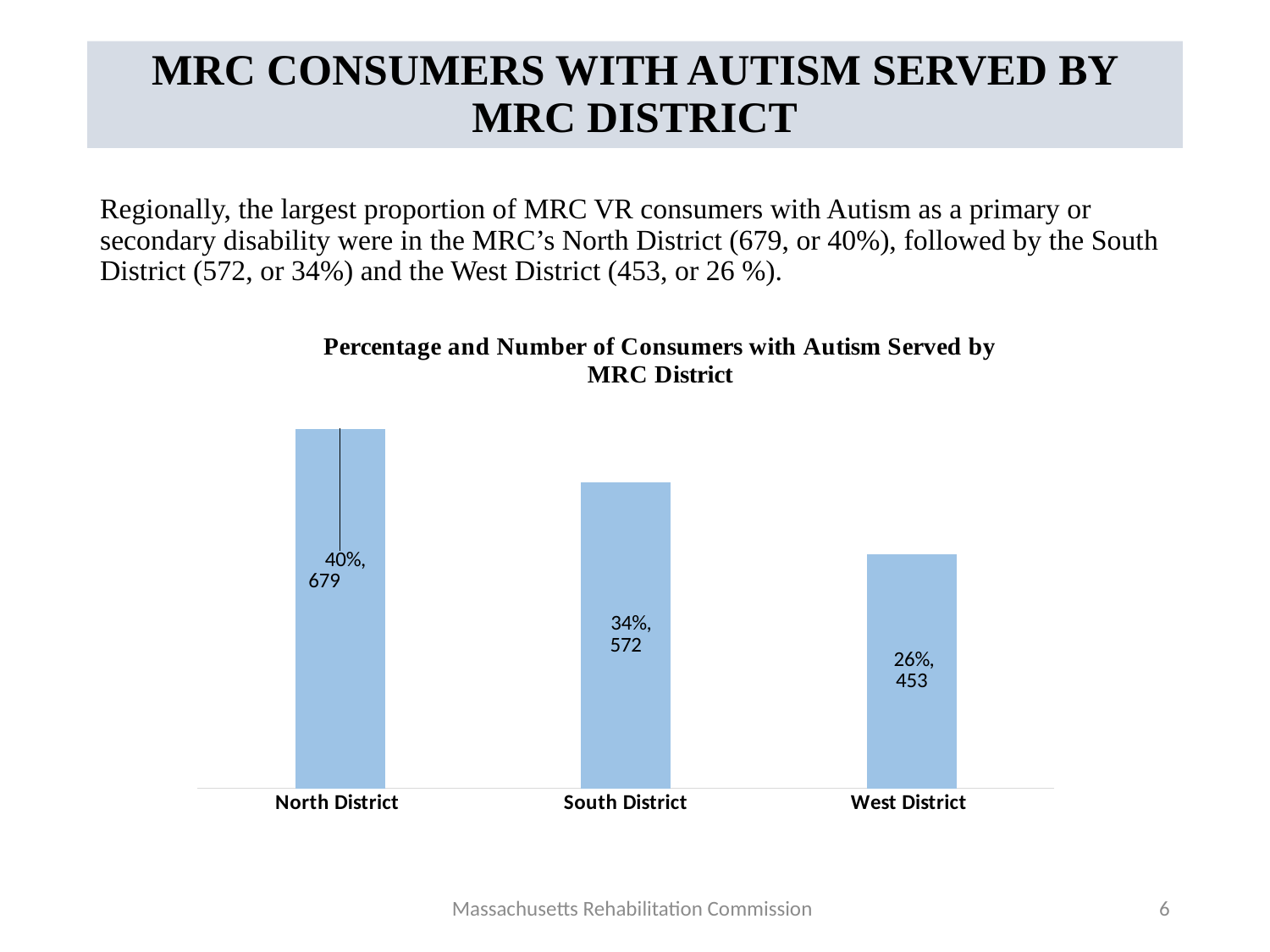
What percentage of consumers with Autism were served in the South District? 34% What is the difference in the number of consumers served between the South District and the West District? 119 Which district has the lowest number of consumers with Autism served? West District How many districts are shown in the chart? 3 Do the values rise or fall from the North District to the West District along the x axis? Fall Which district served more consumers with Autism, the South District or the West District? South District Which district has the highest number of consumers with Autism served? North District What is the title of the chart? Percentage and Number of Consumers with Autism Served by MRC District How many consumers with Autism were served in the West District? 453 What is the difference in the number of consumers served between the North District and the South District? 107 What kind of chart is shown on the slide? Bar chart How many consumers with Autism were served in the North District? 679